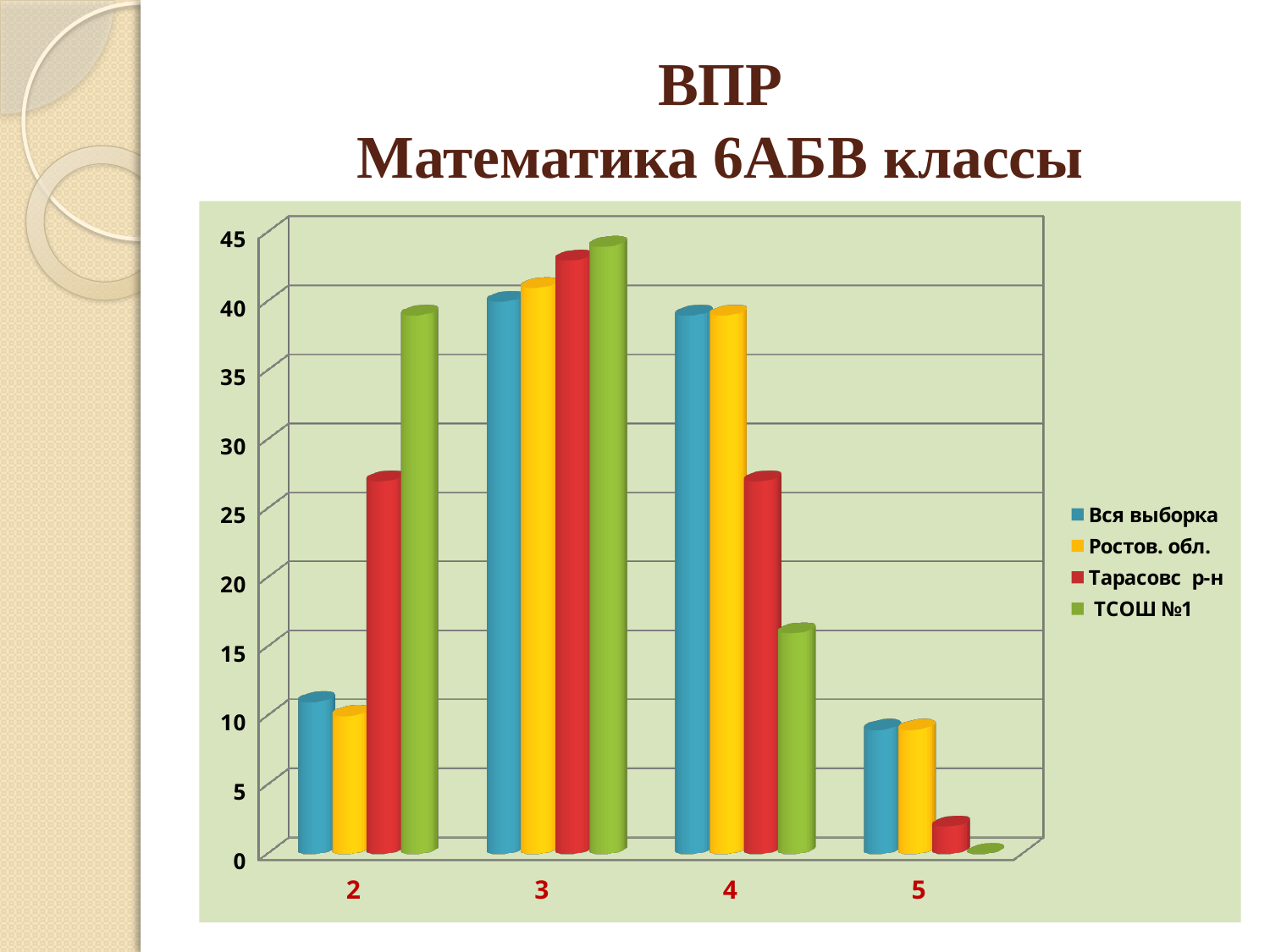
For category 4, which series has the lowest bar? ТСОШ №1 For the series ТСОШ №1, which category has the highest bar? 3 Is the value for ТСОШ №1 in category 2 greater or less than 35? greater What kind of chart is shown on the slide? bar chart How many categories are shown on the x axis? 4 For the series Тарасовс р-н, which category has the lowest bar? 5 Which colour represents Ростов. обл. in the legend? yellow For category 2, which series has the highest bar? ТСОШ №1 Is the value for ТСОШ №1 in category 4 greater or less than 20? less For category 4, which is larger: Вся выборка or ТСОШ №1? Вся выборка For category 2, which is larger: Тарасовс р-н or Вся выборка? Тарасовс р-н How many series does the legend list? 4